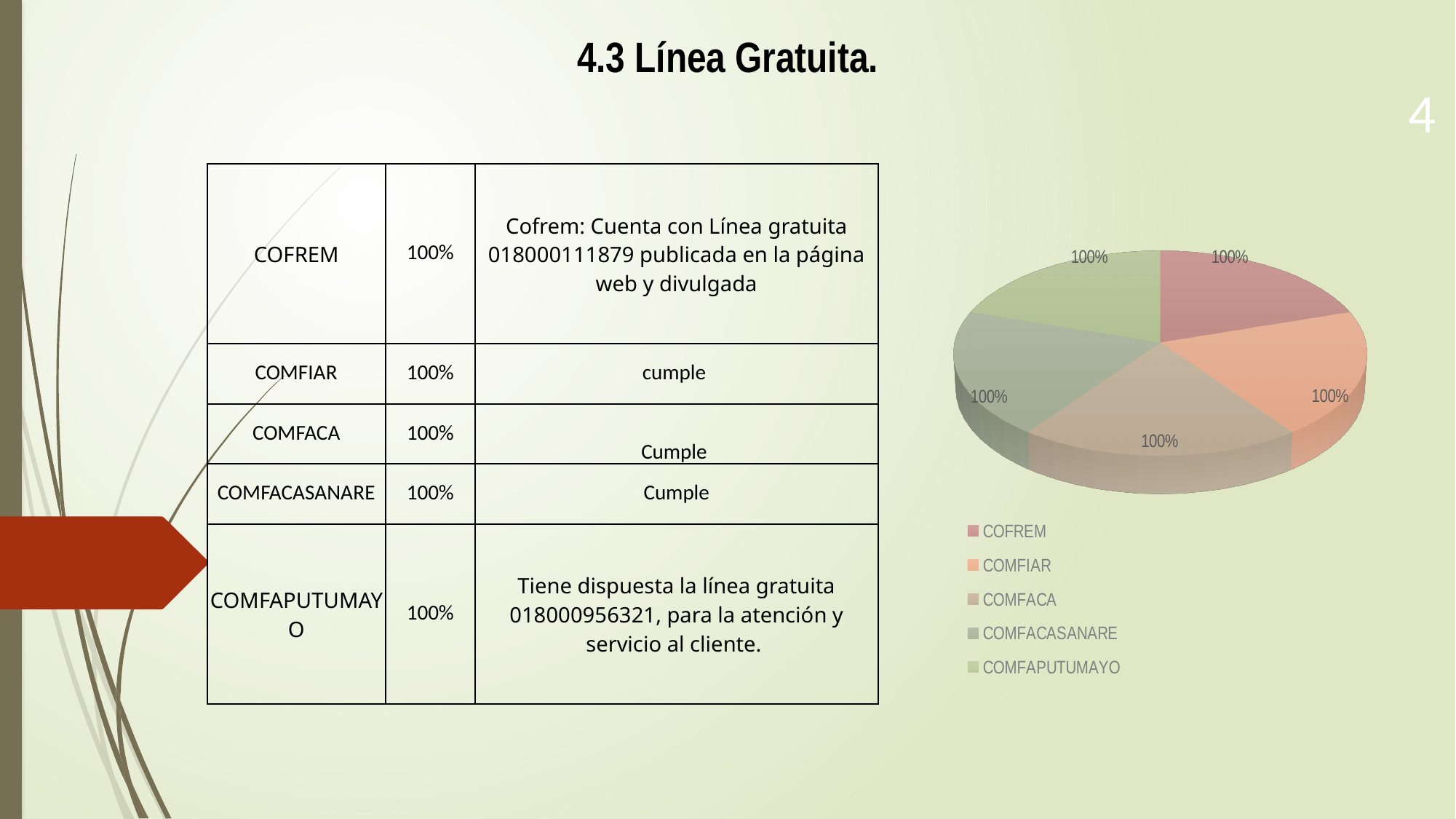
Which legend entry of the pie chart is listed first? COFREM What value is labelled on the COMFACASANARE slice of the pie chart? 100% What kind of chart is shown on the slide? pie chart What value is labelled on the COMFAPUTUMAYO slice of the pie chart? 100% What is the difference between the values labelled for COFREM and COMFIAR in the pie chart? 0% Which legend entry of the pie chart is listed last? COMFAPUTUMAYO What value is labelled on the COMFACA slice of the pie chart? 100% How many slices does the pie chart have? 5 What value is labelled on the COFREM slice of the pie chart? 100% How many entries does the legend of the pie chart list? 5 What value is labelled on the COMFIAR slice of the pie chart? 100%